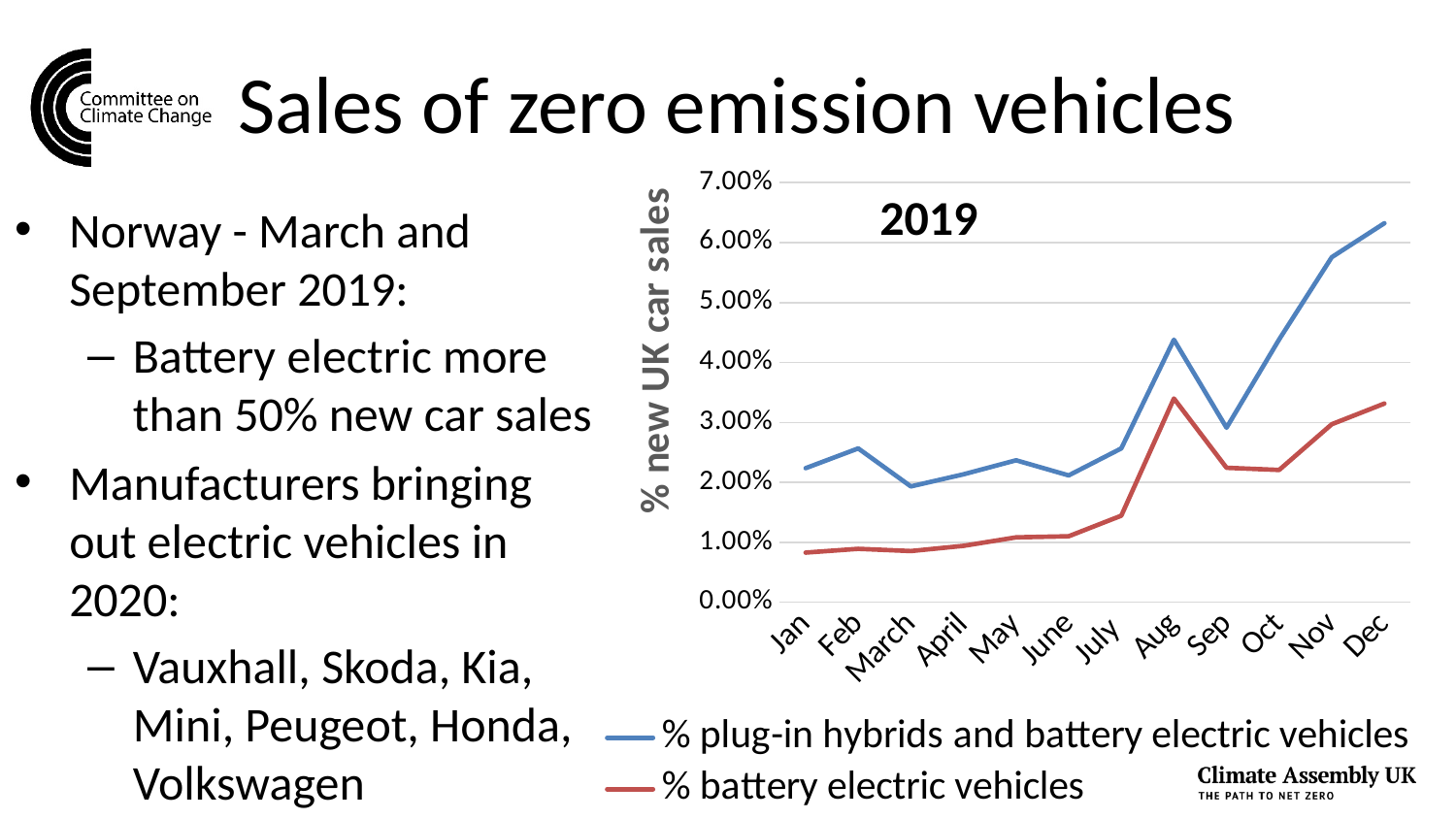
How many series does the chart legend list? 2 Is the value for % plug-in hybrids and battery electric vehicles in Dec greater or less than 6.00%? greater For the % plug-in hybrids and battery electric vehicles series, which month has the larger value, Aug or Sep? Aug Is the value for % plug-in hybrids and battery electric vehicles in Nov greater or less than 5.00%? greater Overall, do the values for % battery electric vehicles rise or fall from Jan to Dec? rise What kind of chart is shown on the slide? line chart What is the title of the chart's vertical axis? % new UK car sales In which month does the % plug-in hybrids and battery electric vehicles series reach its highest value? Dec How many months are plotted along the x axis of the chart? 12 Is the value for % plug-in hybrids and battery electric vehicles in Aug greater or less than 4.00%? greater